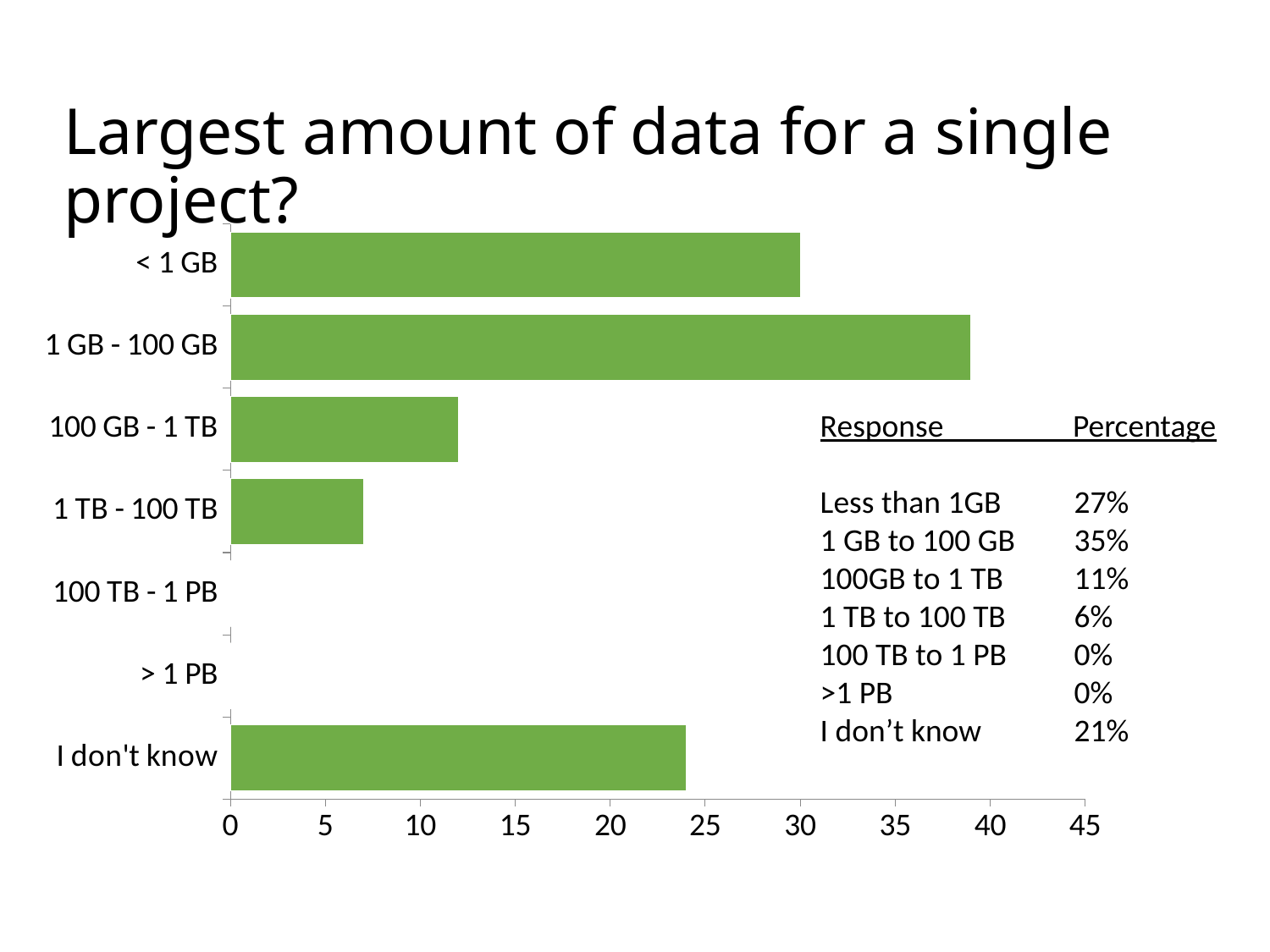
What kind of chart is shown on the slide? bar chart What is the title of the slide's chart? Largest amount of data for a single project? Is the value for 1 TB - 100 TB greater or less than 10? less Is the value for < 1 GB greater or less than 25? greater Which is larger, the value for 100 GB - 1 TB or the value for 1 TB - 100 TB? 100 GB - 1 TB Which is larger, the value for < 1 GB or the value for I don't know? < 1 GB Is the value for I don't know greater or less than 20? greater Which category has the longest bar? 1 GB - 100 GB What colour are the bars in the chart? green How many categories are shown on the chart's vertical axis? 7